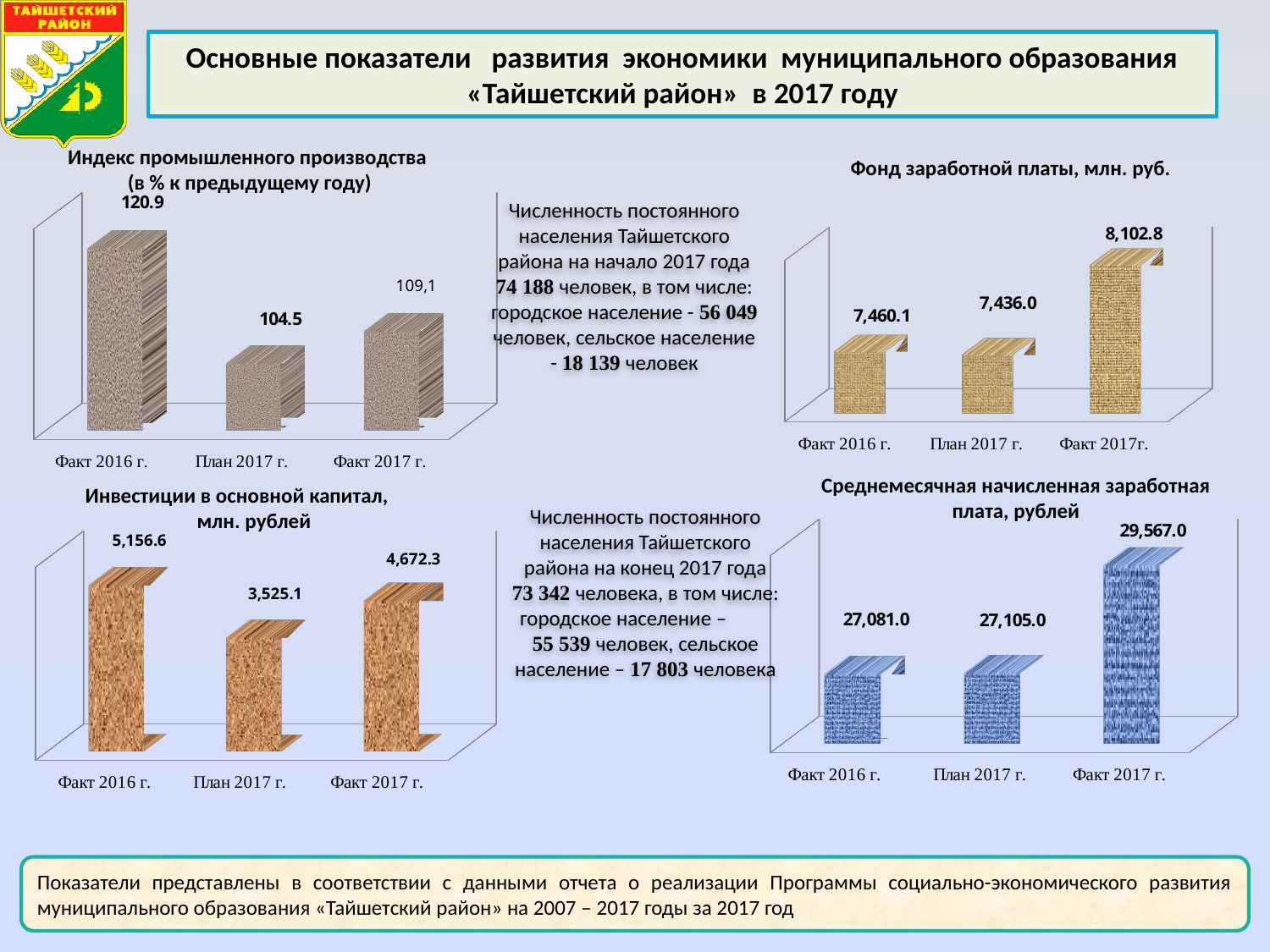
In the chart 'Инвестиции в основной капитал, млн. рублей', how many bars are shown? 3 In the chart 'Инвестиции в основной капитал, млн. рублей', which is larger: Факт 2016 г. or Факт 2017 г.? Факт 2016 г. In the chart 'Среднемесячная начисленная заработная плата, рублей', what is the value for Факт 2017 г.? 29,567.0 In the chart 'Индекс промышленного производства (в % к предыдущему году)', what is the value for Факт 2016 г.? 120.9 In the chart 'Фонд заработной платы, млн. руб.', what is the value for Факт 2017г.? 8,102.8 In the chart 'Фонд заработной платы, млн. руб.', which category has the highest value? Факт 2017г. In the chart 'Фонд заработной платы, млн. руб.', what is the difference between Факт 2017г. and План 2017 г.? 666.8 In the chart 'Индекс промышленного производства (в % к предыдущему году)', what is the difference between Факт 2016 г. and План 2017 г.? 16.4 In the chart 'Среднемесячная начисленная заработная плата, рублей', what is the difference between Факт 2017 г. and Факт 2016 г.? 2,486.0 In the chart 'Инвестиции в основной капитал, млн. рублей', what is the value for План 2017 г.? 3,525.1 In the chart 'Индекс промышленного производства (в % к предыдущему году)', which category has the lowest value? План 2017 г. What type of chart is 'Среднемесячная начисленная заработная плата, рублей'? Bar chart